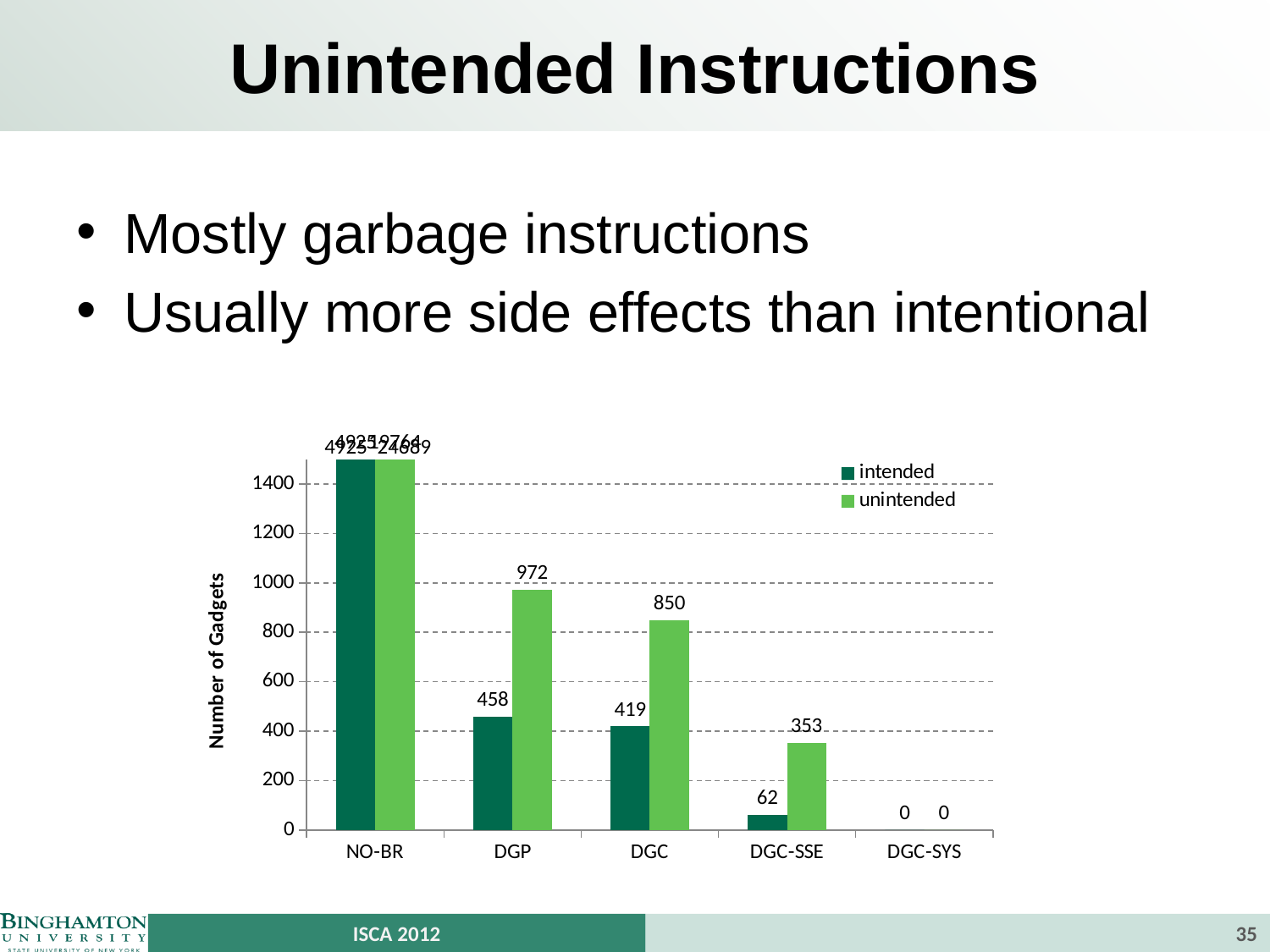
What is the value of the intended series for DGC? 419 What is the difference between the unintended and intended values for DGP? 514 What is the difference between the unintended and intended values for DGC? 431 What is the value of the unintended series for DGP? 972 What is the value of the intended series for DGC-SSE? 62 How many series does the legend list? 2 Which category has the lowest unintended value? DGC-SYS How many categories are shown on the x axis? 5 What is the value of the unintended series for DGC-SSE? 353 Which has a larger intended value, DGP or DGC? DGP What is the title of the y axis? Number of Gadgets What is the value of the intended series for DGC-SYS? 0